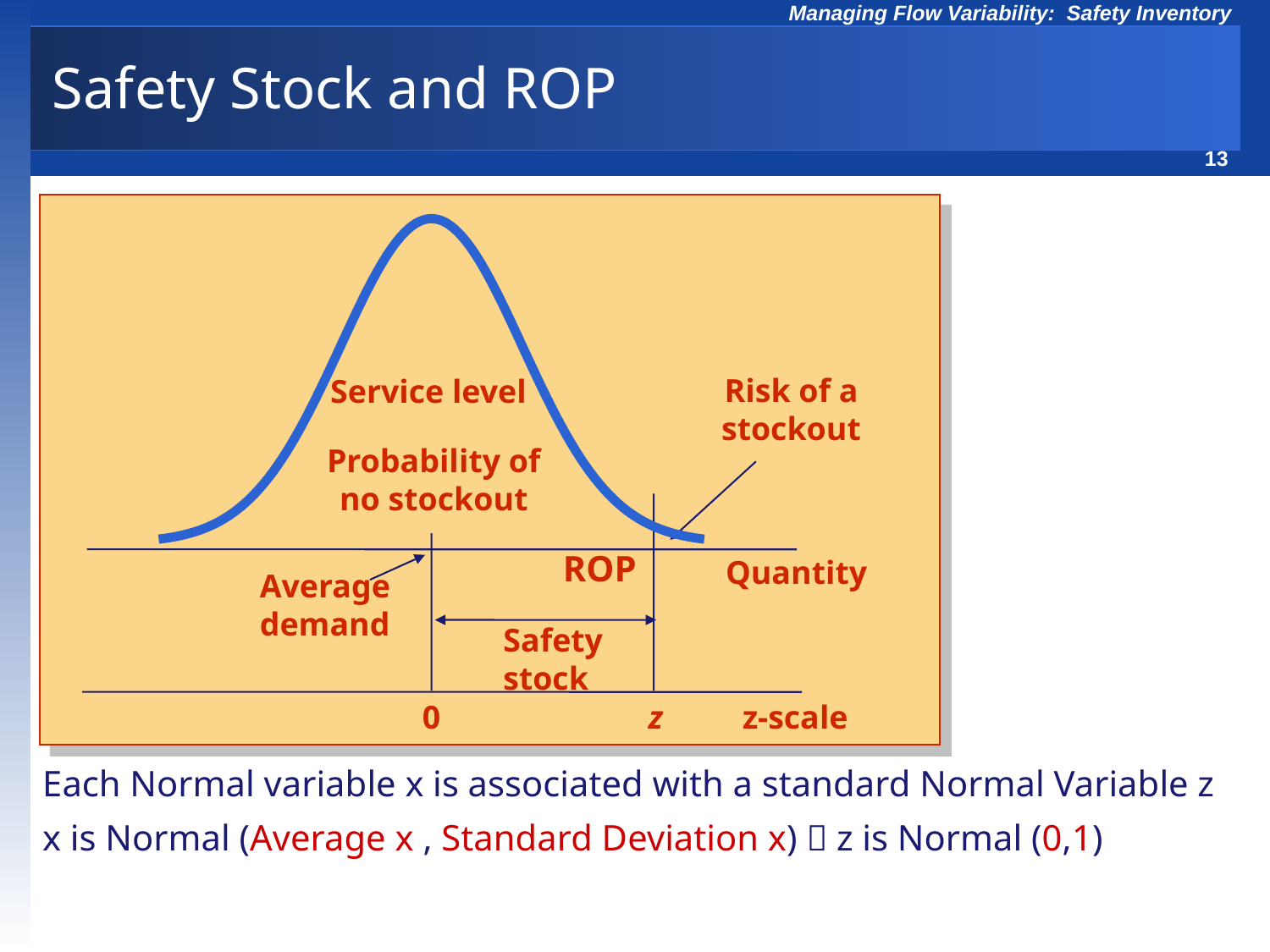
On the z-scale axis, what value is marked directly below the average demand line? 0 How many tick marks are labelled on the z-scale axis? 2 On the z-scale axis, what label is marked directly below the ROP line? z What does the double-headed arrow between the average demand line and the ROP line represent? Safety stock What kind of chart is shown on the slide? A bell-shaped normal distribution curve What does the area of the curve to the right of the ROP line represent? Risk of a stockout